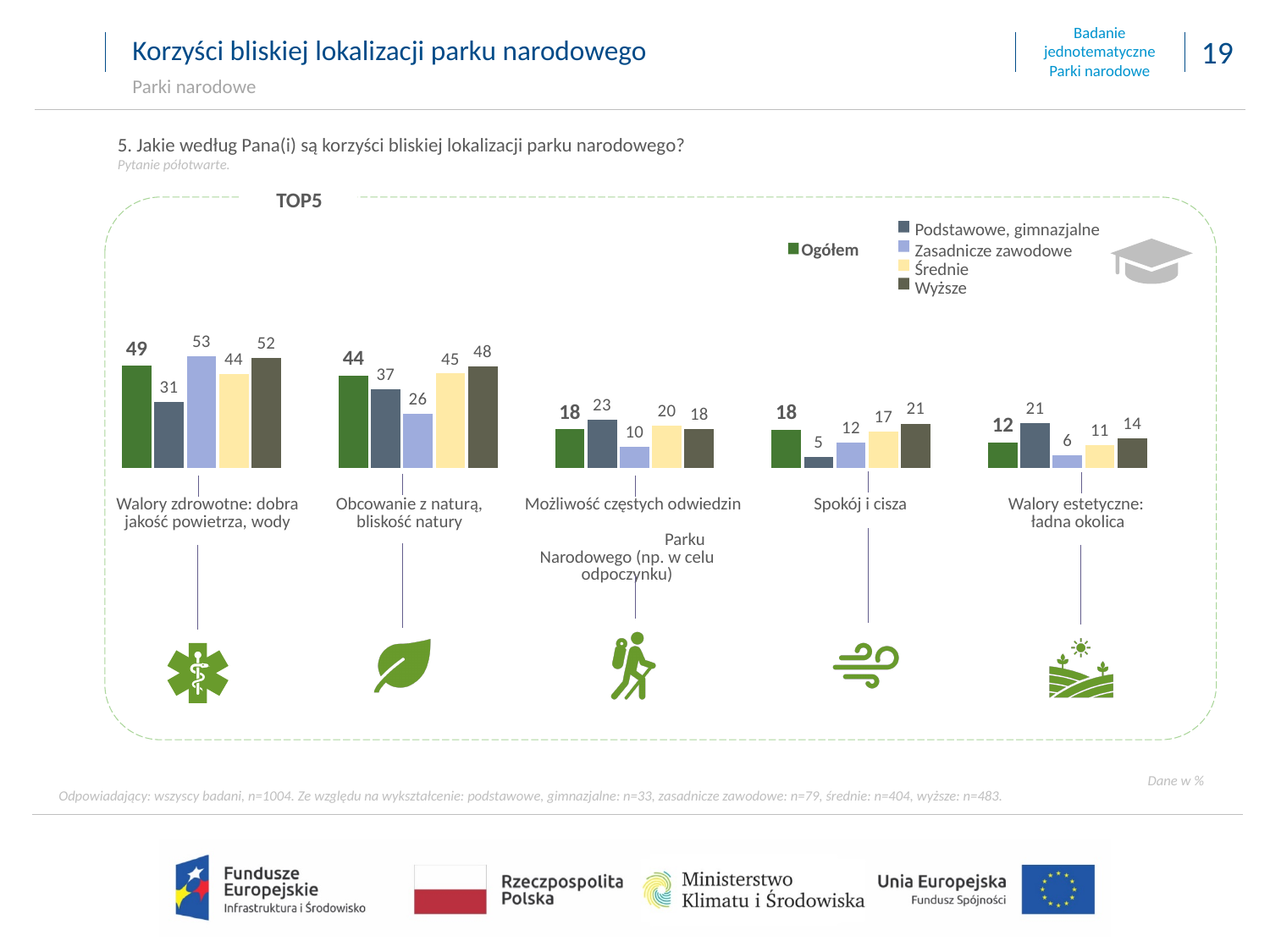
Which category has the highest Ogółem value? Walory zdrowotne: dobra jakość powietrza, wody What is the difference between the Zasadnicze zawodowe and Podstawowe, gimnazjalne values for "Walory zdrowotne: dobra jakość powietrza, wody"? 22 What kind of chart is shown on the slide? Bar chart How many series does the legend list? 5 How many categories are shown in the chart? 5 What is the Wyższe value for "Obcowanie z naturą, bliskość natury"? 48 What is the difference between the Wyższe and Podstawowe, gimnazjalne values for "Spokój i cisza"? 16 What is the Podstawowe, gimnazjalne value for "Spokój i cisza"? 5 What is the Ogółem value for "Walory zdrowotne: dobra jakość powietrza, wody"? 49 Which category has the lowest Ogółem value? Walory estetyczne: ładna okolica For "Możliwość częstych odwiedzin Parku Narodowego", which is larger: the Podstawowe, gimnazjalne value or the Średnie value? Podstawowe, gimnazjalne What is the Zasadnicze zawodowe value for "Walory estetyczne: ładna okolica"? 6